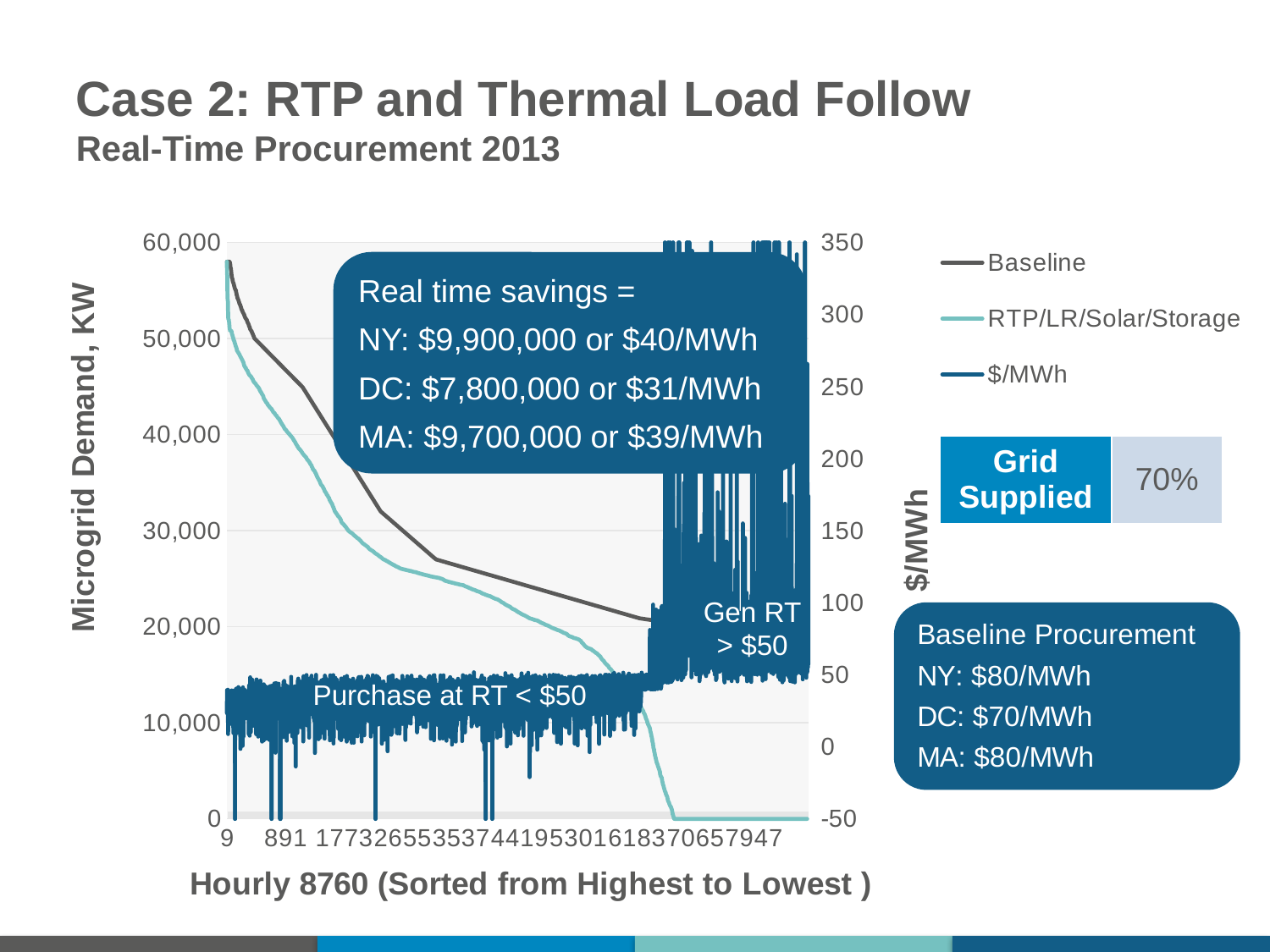
What percentage is shown on the Grid Supplied bar to the right of the chart? 70% In the left portion of the chart, is the $/MWh series mostly greater or less than 50? less What is the title of the left vertical axis of the chart? Microgrid Demand, KW How many series does the chart legend list? 3 Does the RTP/LR/Solar/Storage series rise or fall moving left to right along the x axis? fall Is the RTP/LR/Solar/Storage value at the rightmost end of the chart greater or less than 10,000? less What kind of chart is shown on the slide? line chart What are the three series named in the chart legend? Baseline, RTP/LR/Solar/Storage, $/MWh Is the Baseline value at the rightmost end of the chart greater or less than 30,000? less Does the Baseline series rise or fall moving left to right along the x axis? fall Across the middle of the chart, which line is higher, Baseline or RTP/LR/Solar/Storage? Baseline